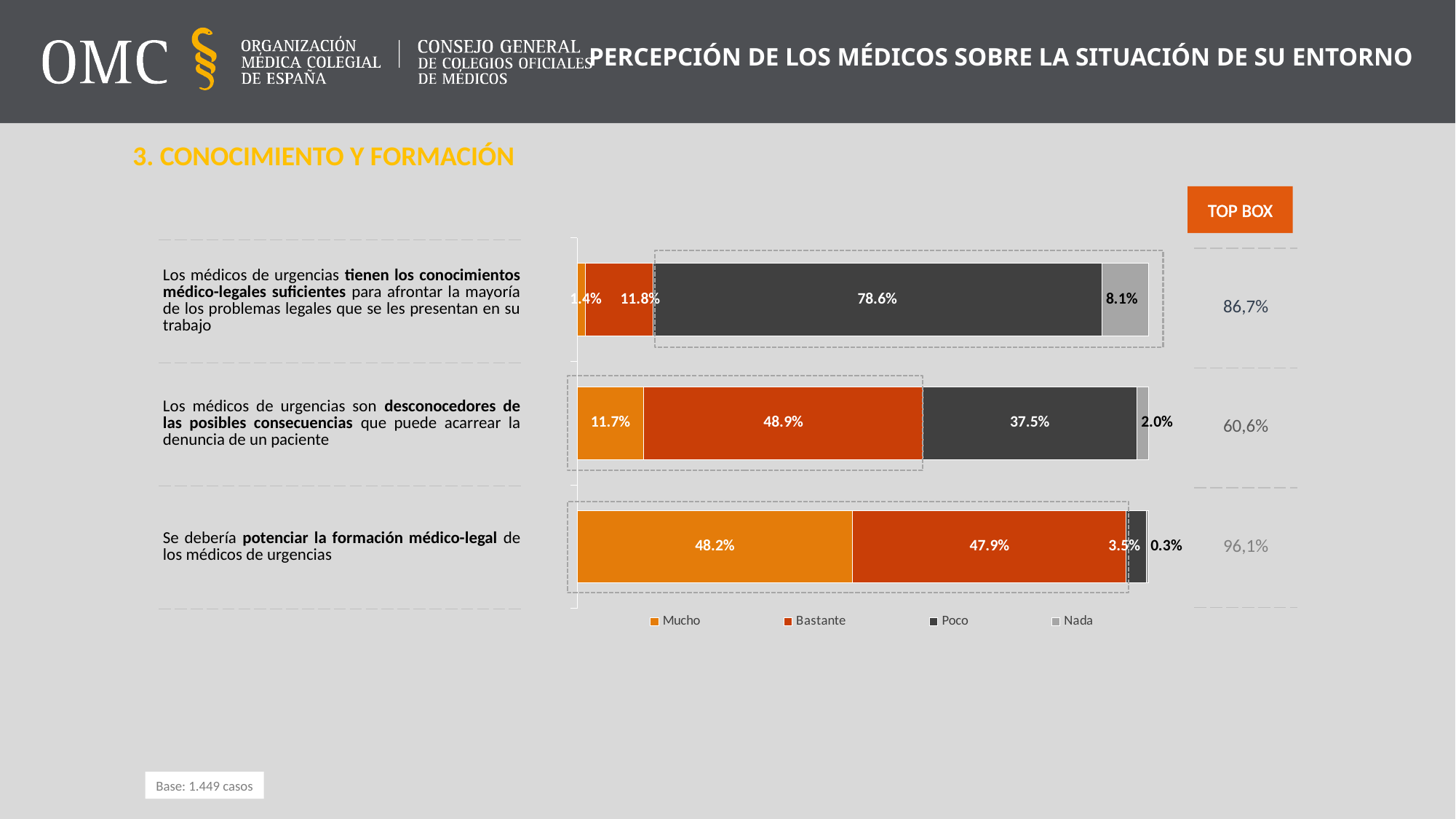
For the statement "Se debería potenciar la formación médico-legal", which is larger: the "Mucho" value or the "Bastante" value? Mucho (48.2%) Which statement has the highest "Mucho" percentage? Se debería potenciar la formación médico-legal de los médicos de urgencias What type of chart is shown on the slide? Stacked bar chart What percentage of respondents answered "Poco" to the statement that emergency doctors have sufficient medico-legal knowledge ("tienen los conocimientos médico-legales suficientes")? 78.6% What is the combined "Mucho" plus "Bastante" share for the statement about emergency doctors being unaware of the consequences of a patient complaint? 60.6% What is the "Mucho" value for the statement "Se debería potenciar la formación médico-legal de los médicos de urgencias"? 48.2% How many series does the chart legend list? 4 What is the "Bastante" value for the statement that emergency doctors are unaware of the possible consequences of a patient complaint ("desconocedores de las posibles consecuencias")? 48.9% What is the "Nada" value for the first statement, about emergency doctors having sufficient medico-legal knowledge? 8.1% How many statements are plotted in the chart? 3 Which statement has the lowest "Nada" percentage? Se debería potenciar la formación médico-legal de los médicos de urgencias For the first statement (sufficient medico-legal knowledge), how much larger is the "Poco" value than the "Bastante" value? 66.8 percentage points